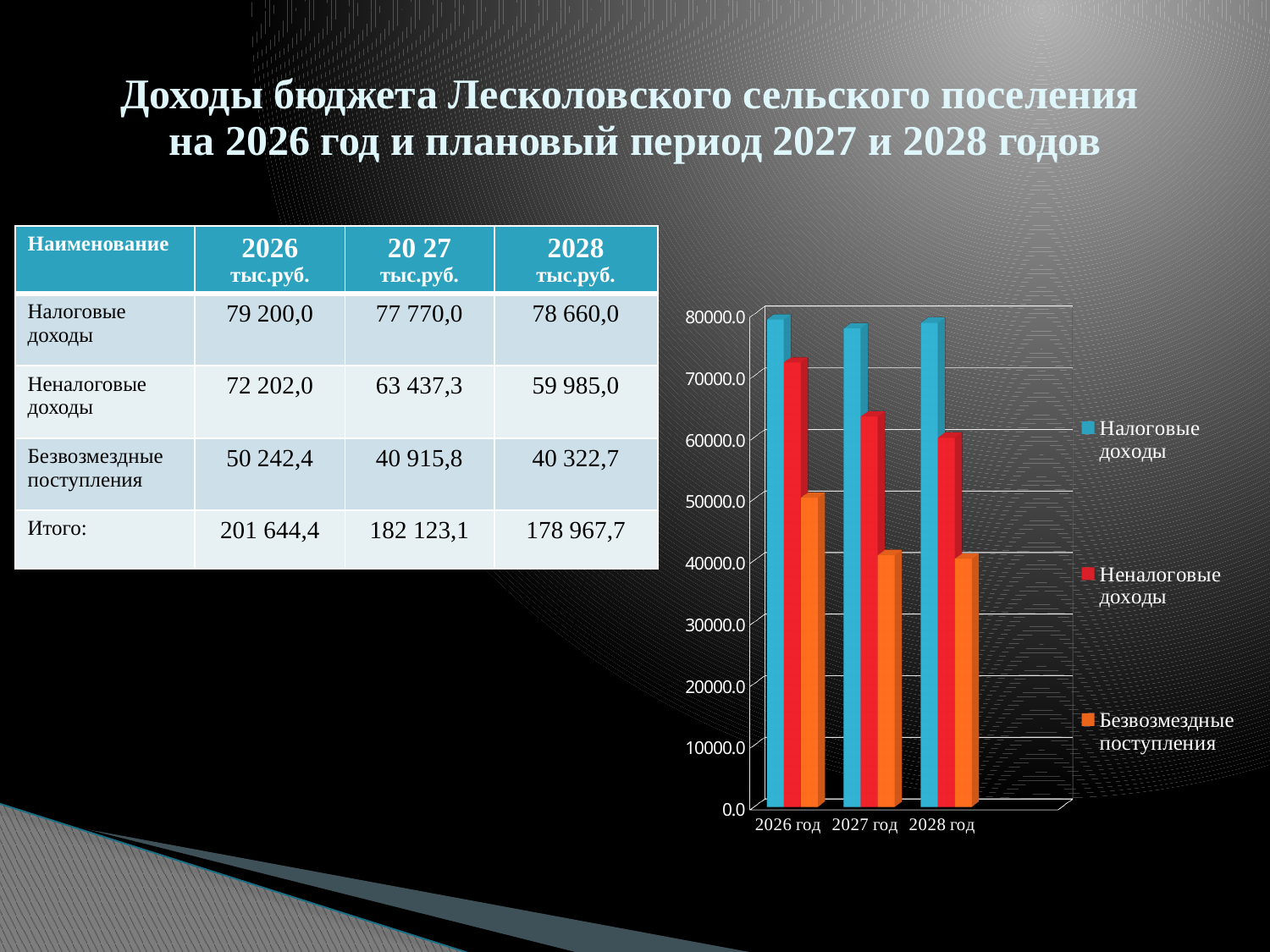
What colour are the bars for Налоговые доходы in the chart? blue Which series has the shortest bar for 2028 год? Безвозмездные поступления According to the table on the slide, what is the value of Налоговые доходы for 2026 (тыс.руб.)? 79 200,0 According to the table on the slide, what is the difference between Итого for 2026 and Итого for 2028 (тыс.руб.)? 22 676,7 Is the value for Безвозмездные поступления in 2028 год greater or less than 50000.0? less Do the values for Неналоговые доходы rise or fall from 2026 год to 2028 год? fall How many series does the chart legend list? 3 What kind of chart is shown on the slide? bar chart How many year categories are shown on the x axis of the chart? 3 In 2026 год, which is larger: Неналоговые доходы or Безвозмездные поступления? Неналоговые доходы Is the value for Неналоговые доходы in 2027 год greater or less than 60000.0? greater Which series has the tallest bar for 2026 год? Налоговые доходы